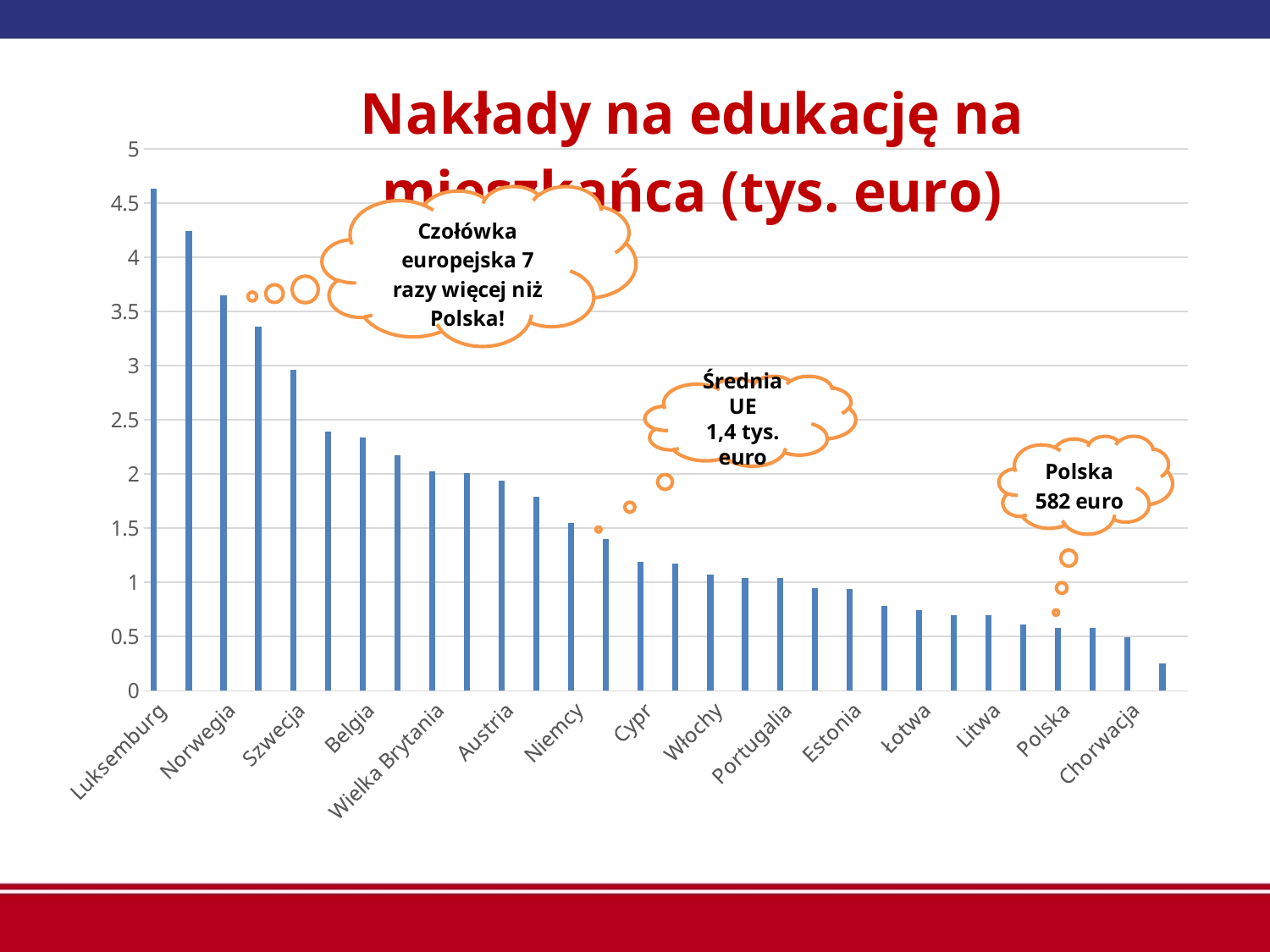
Is the value for Chorwacja greater or less than 1? less Is the value for Norwegia greater or less than 3? greater Which is larger, the value for Luksemburg or the value for Polska? Luksemburg Is the value for Polska greater or less than 1? less What is the title of the chart? Nakłady na edukację na mieszkańca (tys. euro) Do the values rise or fall moving from left to right along the x axis? fall What kind of chart is shown on the slide? bar chart Which country has the highest education spending per inhabitant in the chart? Luksemburg According to the callout on the chart, what is the EU average (Średnia UE) education spending per inhabitant? 1,4 tys. euro According to the callout on the chart, what is the education spending per inhabitant in Polska? 582 euro